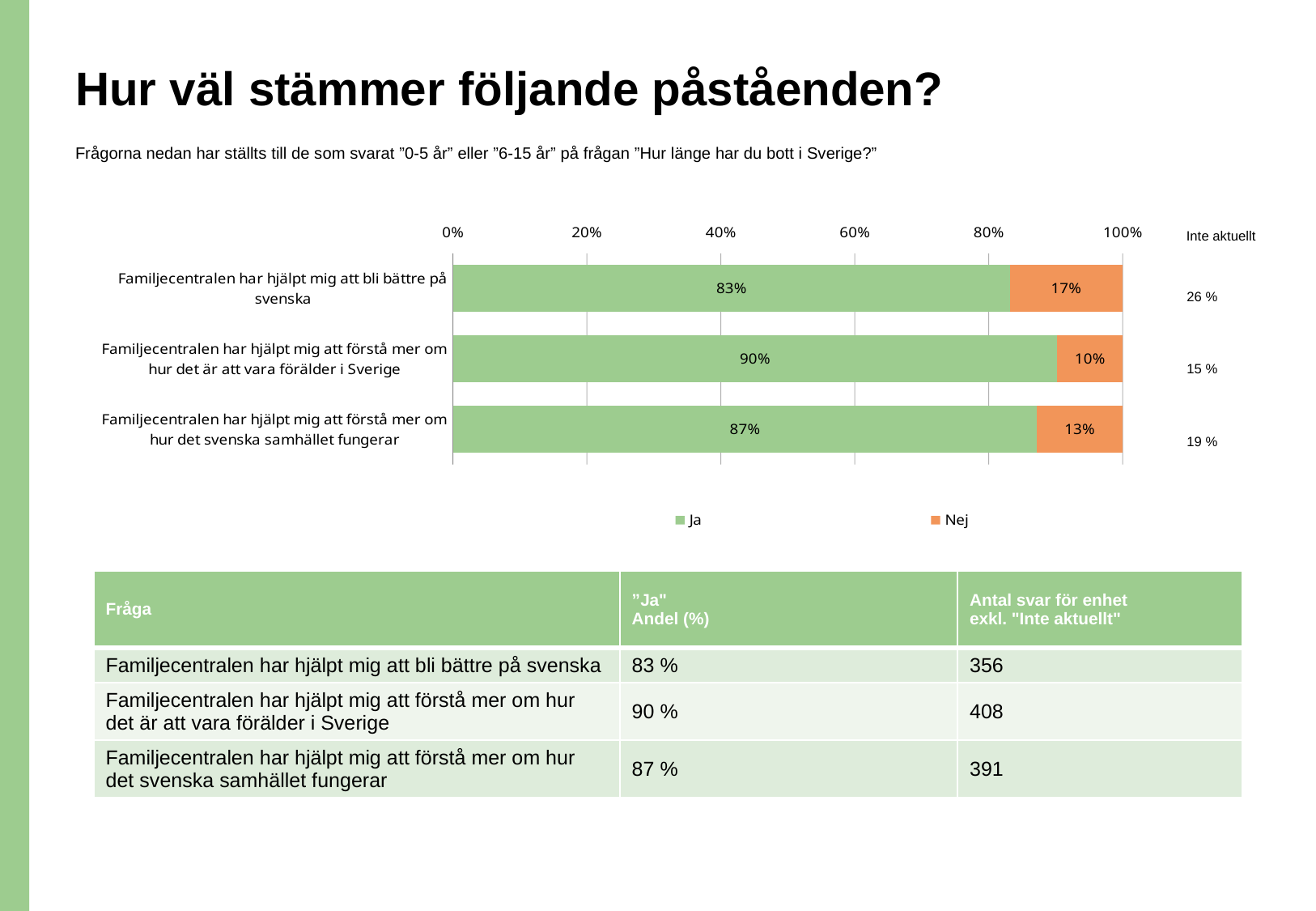
Which is larger: the "Ja" value for "bli bättre på svenska" or the "Ja" value for "förstå mer om hur det svenska samhället fungerar"? förstå mer om hur det svenska samhället fungerar Which statement has the highest "Ja" share? Familjecentralen har hjälpt mig att förstå mer om hur det är att vara förälder i Sverige Which statement has the lowest "Ja" share? Familjecentralen har hjälpt mig att bli bättre på svenska How many statements (categories) are shown in the chart? 3 What is the "Nej" value for "Familjecentralen har hjälpt mig att förstå mer om hur det är att vara förälder i Sverige"? 10% What are the two legend entries in the chart? Ja and Nej How many series does the legend list? 2 What is the "Ja" value for "Familjecentralen har hjälpt mig att förstå mer om hur det svenska samhället fungerar"? 87% What kind of chart is shown on the slide? Stacked bar chart What is the total of the stacked bar for "Familjecentralen har hjälpt mig att förstå mer om hur det är att vara förälder i Sverige"? 100% What is the "Ja" value for "Familjecentralen har hjälpt mig att bli bättre på svenska"? 83% What is the difference between the "Nej" values for "bli bättre på svenska" and "förstå mer om hur det svenska samhället fungerar"? 4%